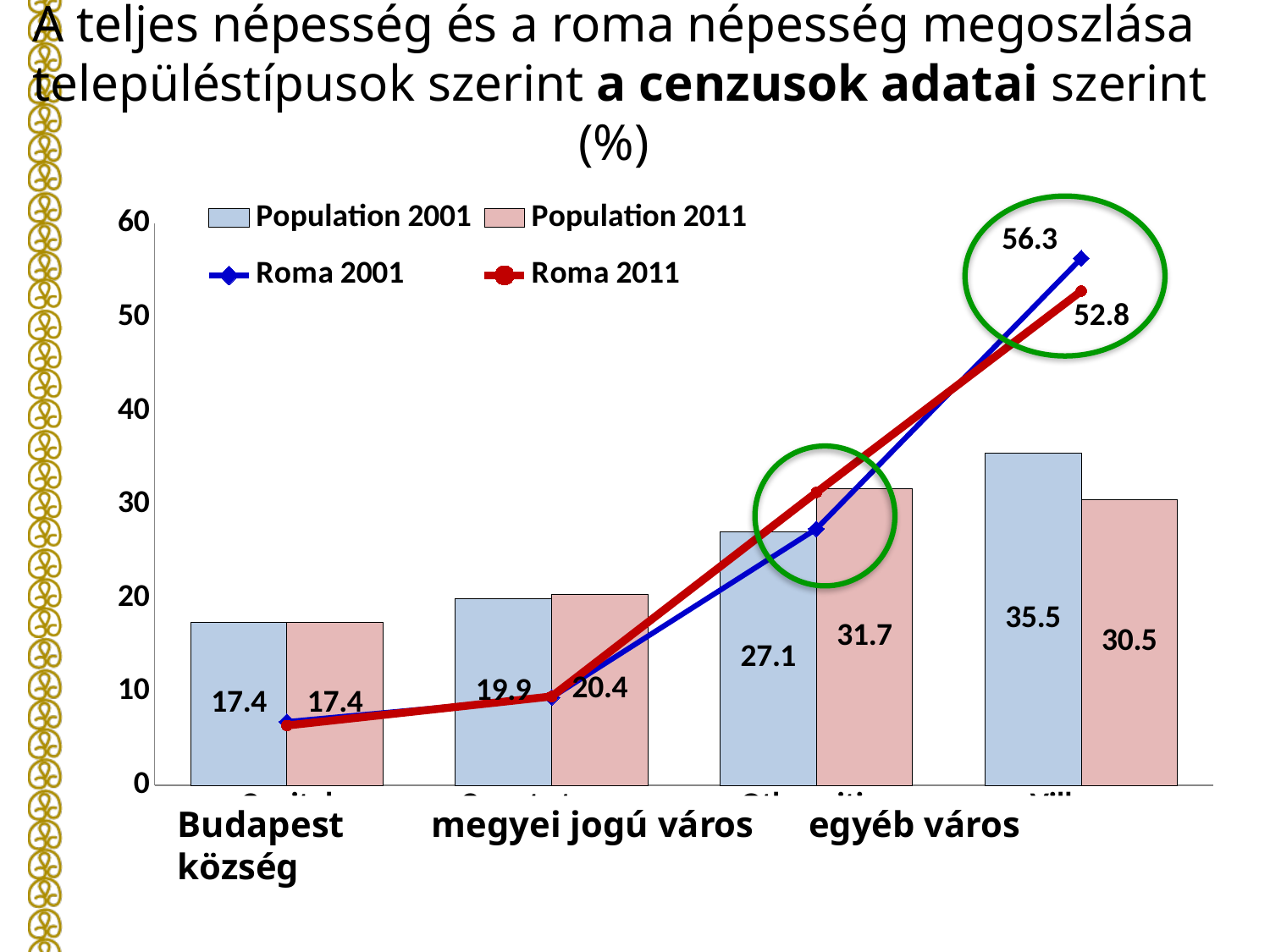
How much higher is the Roma 2001 value than the Roma 2011 value for the rightmost category (község)? 3.5 What is the Population 2001 value for Budapest? 17.4 How many series does the legend list? 4 What is the Population 2011 value for egyéb város? 31.7 Which category has the highest Population 2001 value? község (the rightmost category) What is the Roma 2011 value for the rightmost category (község)? 52.8 What is the difference between the Population 2011 and Population 2001 values for egyéb város? 4.6 For the rightmost category (község), which is larger: Population 2001 or Population 2011? Population 2001 What kind of chart is shown on the slide? A combination bar and line chart What is the Roma 2001 value for the rightmost category (község)? 56.3 Is the Roma 2001 value for Budapest greater or less than 10? less How many categories are shown on the x axis? 4